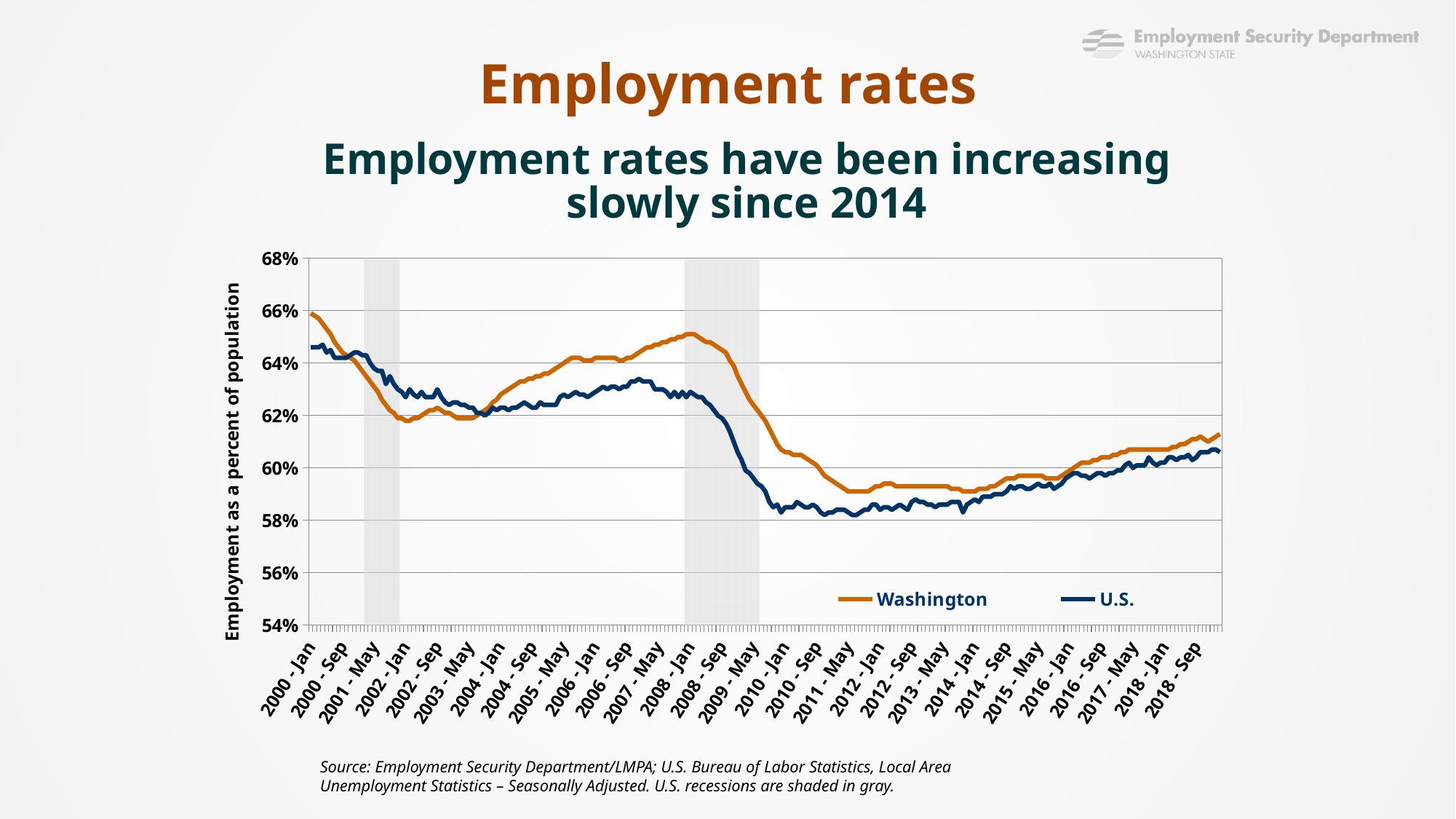
At 2008 - Jan, which series has the higher value, Washington or U.S.? Washington Is the U.S. value at 2011 - May greater or less than 60%? less Is the Washington value at 2018 - Sep greater or less than 60%? greater Is the Washington value at 2000 - Jan greater or less than 64%? greater Do the Washington values rise or fall between 2008 - Jan and 2010 - Jan? fall How many series does the legend list? 2 At 2000 - Jan, which series has the higher value, Washington or U.S.? Washington What are the two series named in the legend? Washington and U.S. Do the U.S. values rise or fall between 2014 - Jan and 2018 - Sep? rise What kind of chart is shown on the slide? Line chart What is the label on the vertical axis? Employment as a percent of population